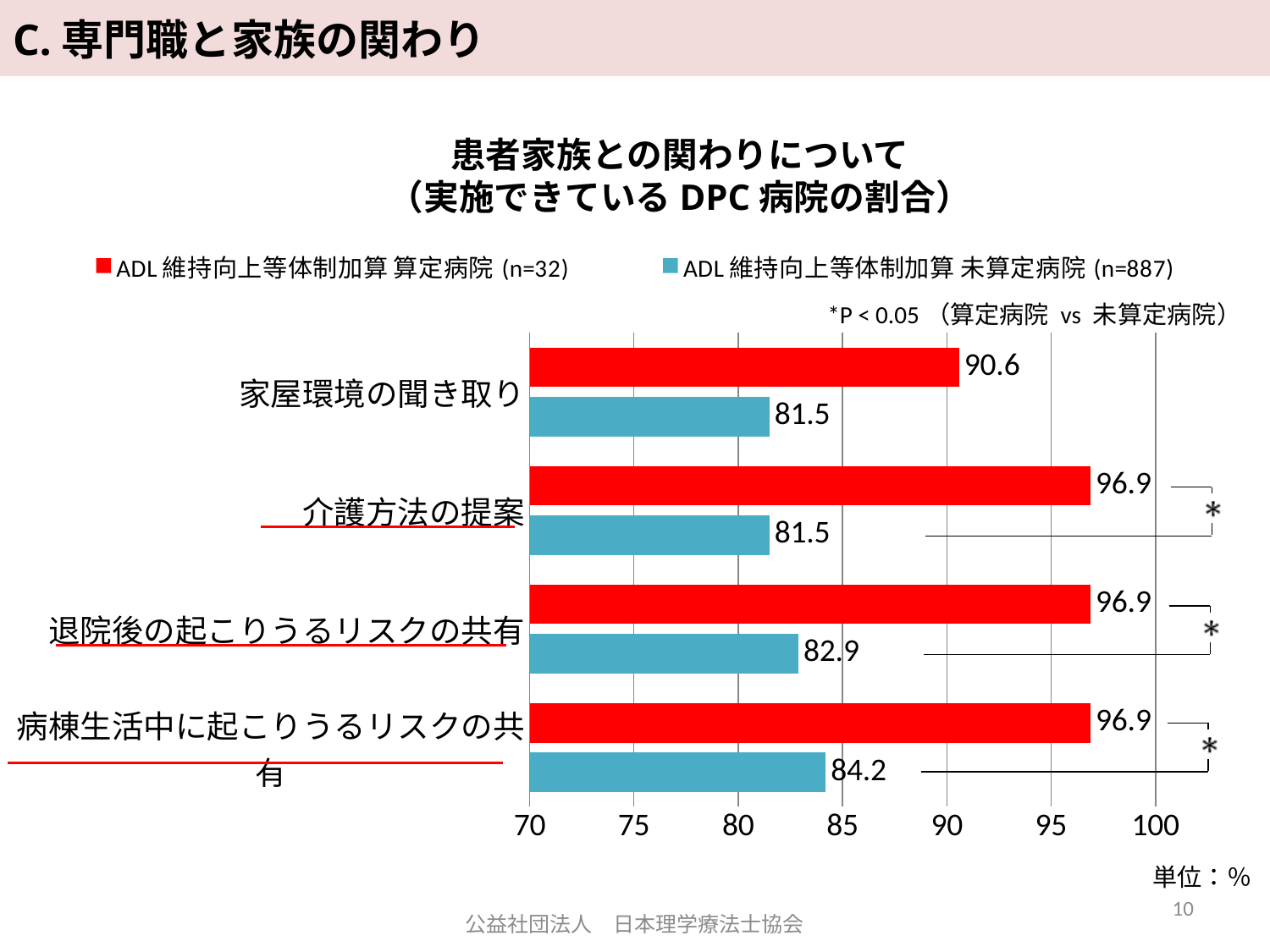
What is the difference between 算定病院 and 未算定病院 in the 家屋環境の聞き取り category? 9.1 What is the difference between 算定病院 and 未算定病院 in the 介護方法の提案 category? 15.4 How many categories are shown on the chart? 4 What is the value for 算定病院 (n=32) in the 家屋環境の聞き取り category? 90.6 Which category has the highest value for 未算定病院 (n=887)? 病棟生活中に起こりうるリスクの共有 What kind of chart is shown on the slide? Bar chart What is the value for 未算定病院 (n=887) in the 退院後の起こりうるリスクの共有 category? 82.9 In the 退院後の起こりうるリスクの共有 category, which series has the larger value, 算定病院 or 未算定病院? 算定病院 Which category has the lowest value for 算定病院 (n=32)? 家屋環境の聞き取り What unit is indicated for the values on the chart? % How many series does the legend list? 2 What is the value for 未算定病院 (n=887) in the 病棟生活中に起こりうるリスクの共有 category? 84.2